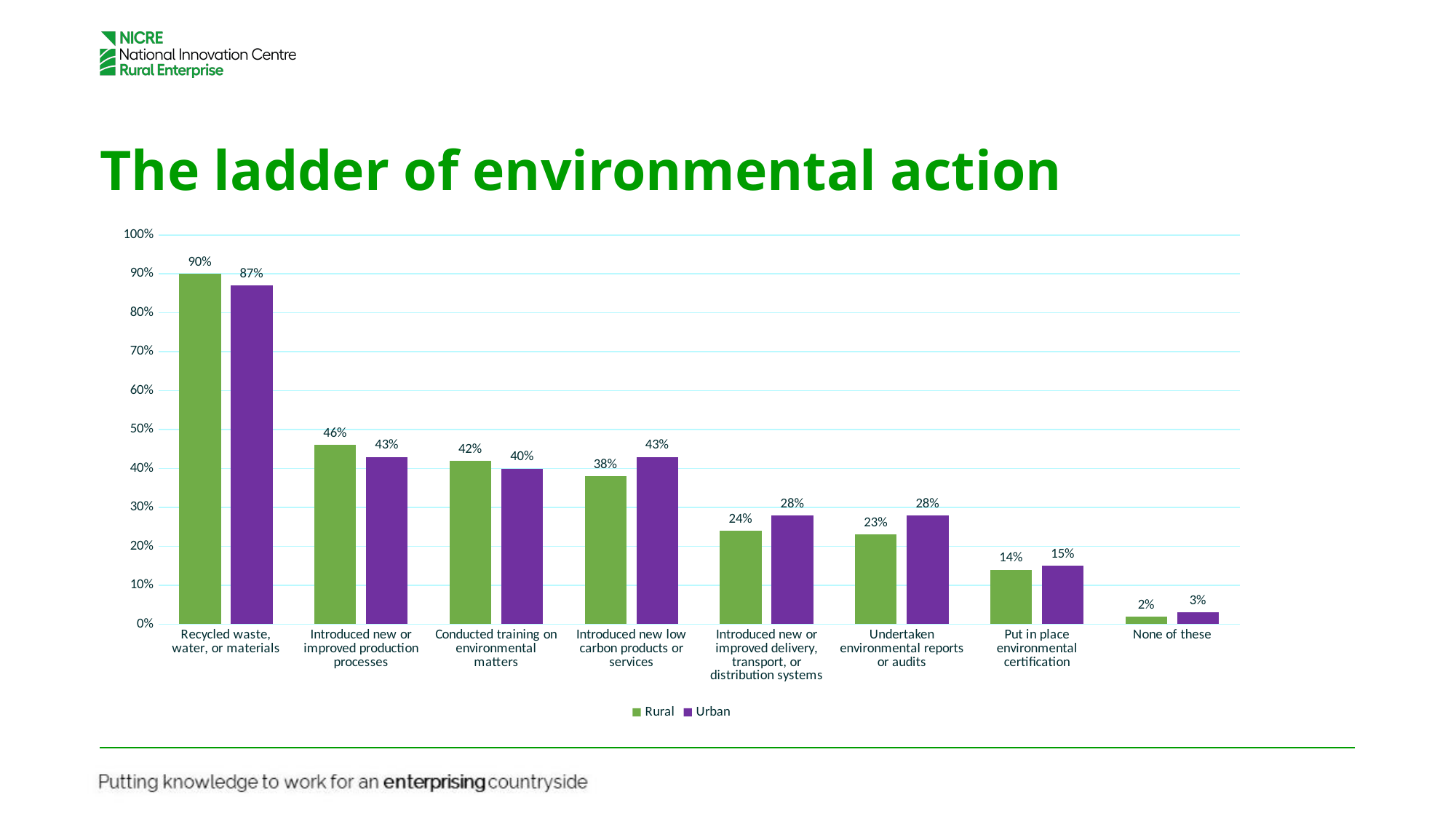
Which category has the highest Urban value? Recycled waste, water, or materials What is the Rural value for "Recycled waste, water, or materials"? 90% What is the Urban value for "Introduced new low carbon products or services"? 43% What is the Rural value for "Put in place environmental certification"? 14% How many series does the legend list? 2 How many categories are shown on the x axis? 8 What colour are the Urban bars? Purple Which category has the lowest Rural value? None of these What is the difference between the Rural and Urban values for "Introduced new or improved production processes"? 3% Is the Urban value for "Conducted training on environmental matters" greater or less than 50%? less For "Undertaken environmental reports or audits", which is larger, the Rural or the Urban value? Urban What kind of chart is shown on the slide? Bar chart